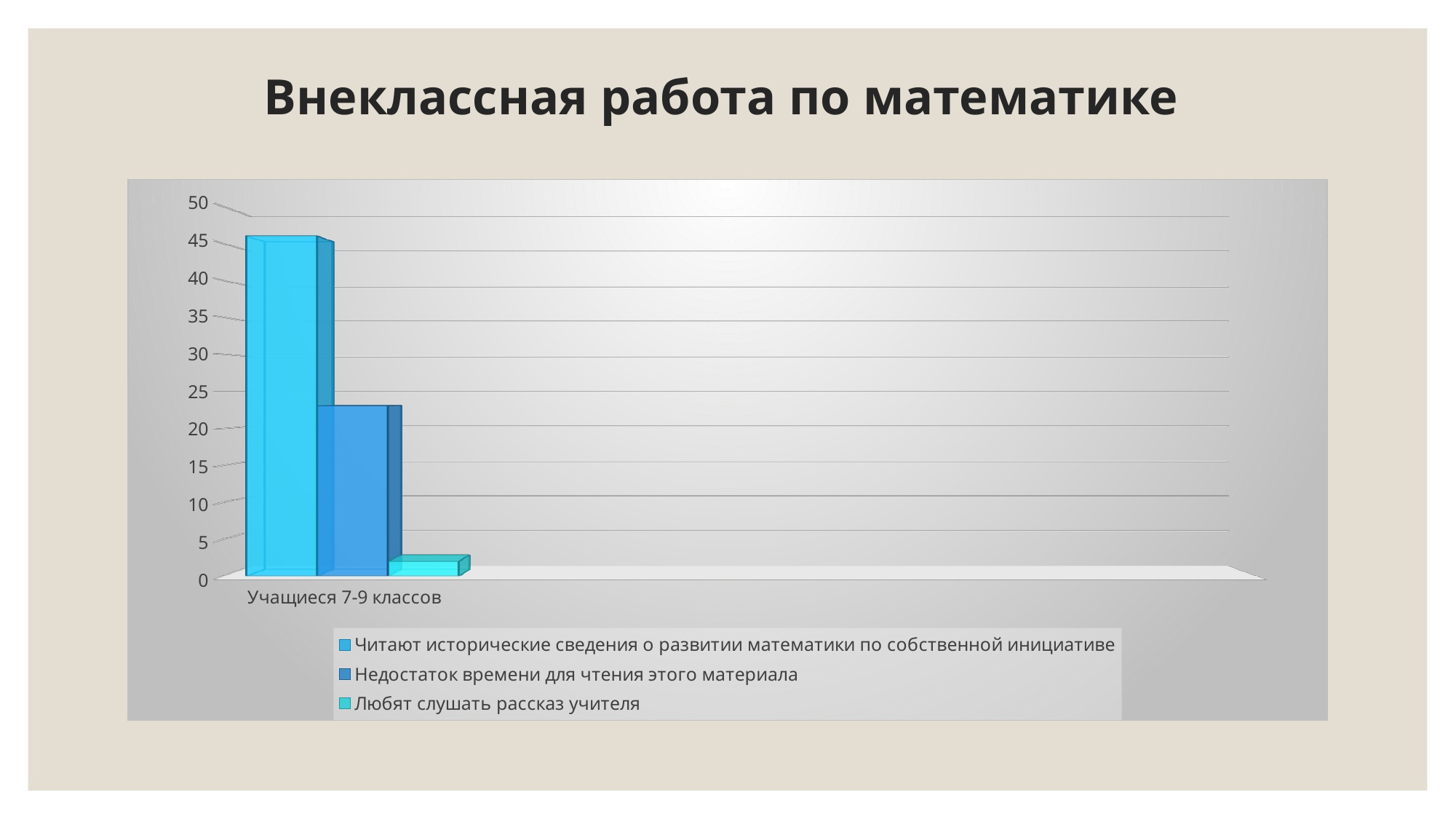
How many categories are shown on the x axis? 1 Which series has the highest value for Учащиеся 7-9 классов? Читают исторические сведения о развитии математики по собственной инициативе Is the value for Любят слушать рассказ учителя greater or less than 5? less How many series does the legend list? 3 What is the label of the category on the x axis? Учащиеся 7-9 классов Is the value for Читают исторические сведения о развитии математики по собственной инициативе greater or less than 40? greater Which is larger: the value for Недостаток времени для чтения этого материала or the value for Любят слушать рассказ учителя? Недостаток времени для чтения этого материала What is the title of the slide? Внеклассная работа по математике What kind of chart is shown on the slide? bar chart Is the value for Недостаток времени для чтения этого материала greater or less than 30? less Which series has the lowest value for Учащиеся 7-9 классов? Любят слушать рассказ учителя